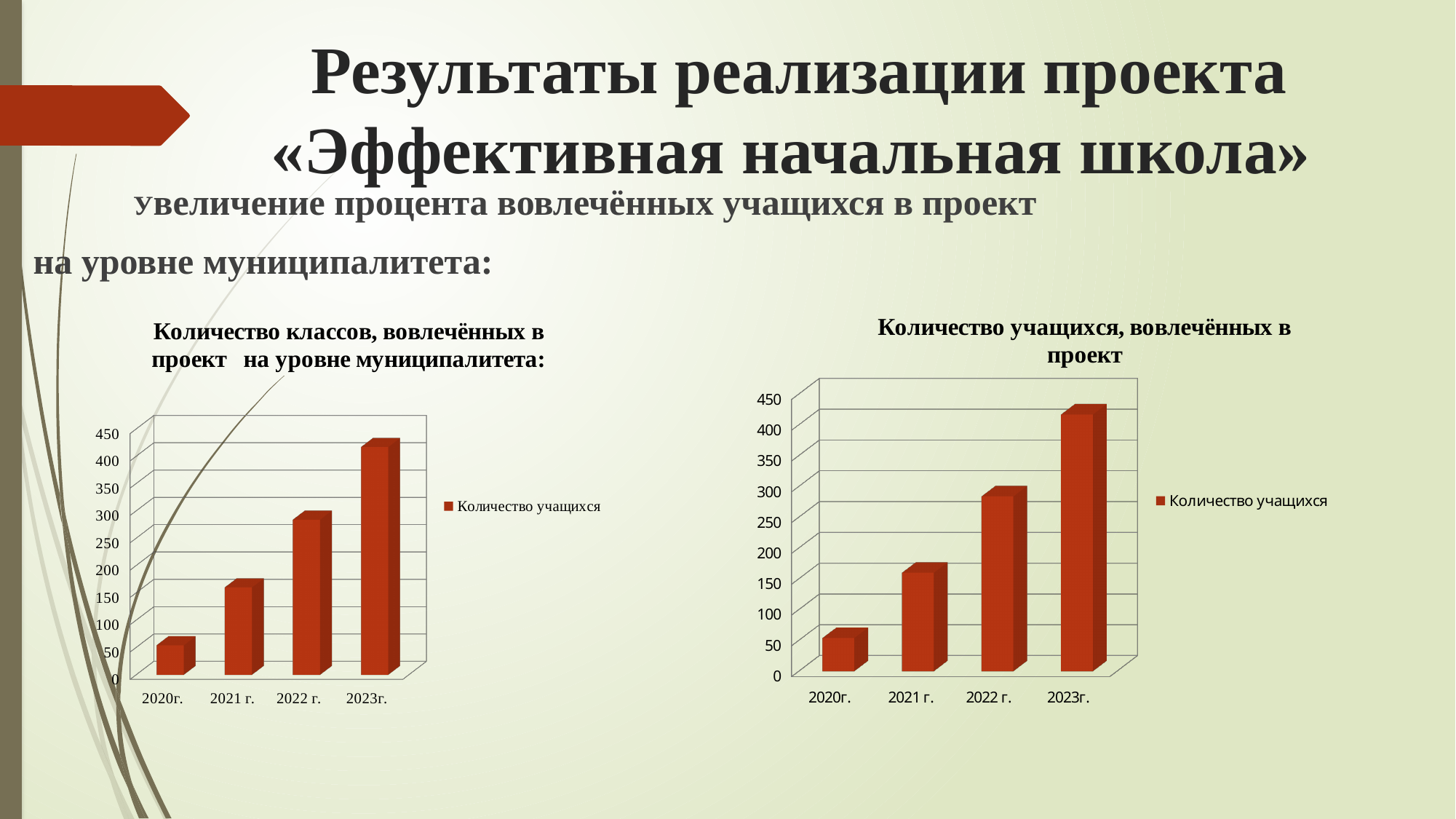
In the right chart «Количество учащихся, вовлечённых в проект», do the values rise or fall from 2020г. to 2023г.? rise What kind of chart is the left chart titled «Количество классов, вовлечённых в проект на уровне муниципалитета»? bar chart In the left chart «Количество классов, вовлечённых в проект на уровне муниципалитета», is the value for 2020г. greater or less than 100? less In the right chart «Количество учащихся, вовлечённых в проект», which year has the highest value? 2023г. In the right chart «Количество учащихся, вовлечённых в проект», is the value for 2021 г. greater or less than 100? greater What is the legend entry shown in the right chart «Количество учащихся, вовлечённых в проект»? Количество учащихся How many series does the legend of the left chart «Количество классов, вовлечённых в проект на уровне муниципалитета» list? 1 How many years are shown on the x axis of the right chart «Количество учащихся, вовлечённых в проект»? 4 In the left chart «Количество классов, вовлечённых в проект на уровне муниципалитета», which year has the lowest value? 2020г. In the right chart «Количество учащихся, вовлечённых в проект», is the value for 2023г. greater or less than 350? greater In the right chart «Количество учащихся, вовлечённых в проект», which is larger, the value for 2021 г. or the value for 2022 г.? 2022 г.